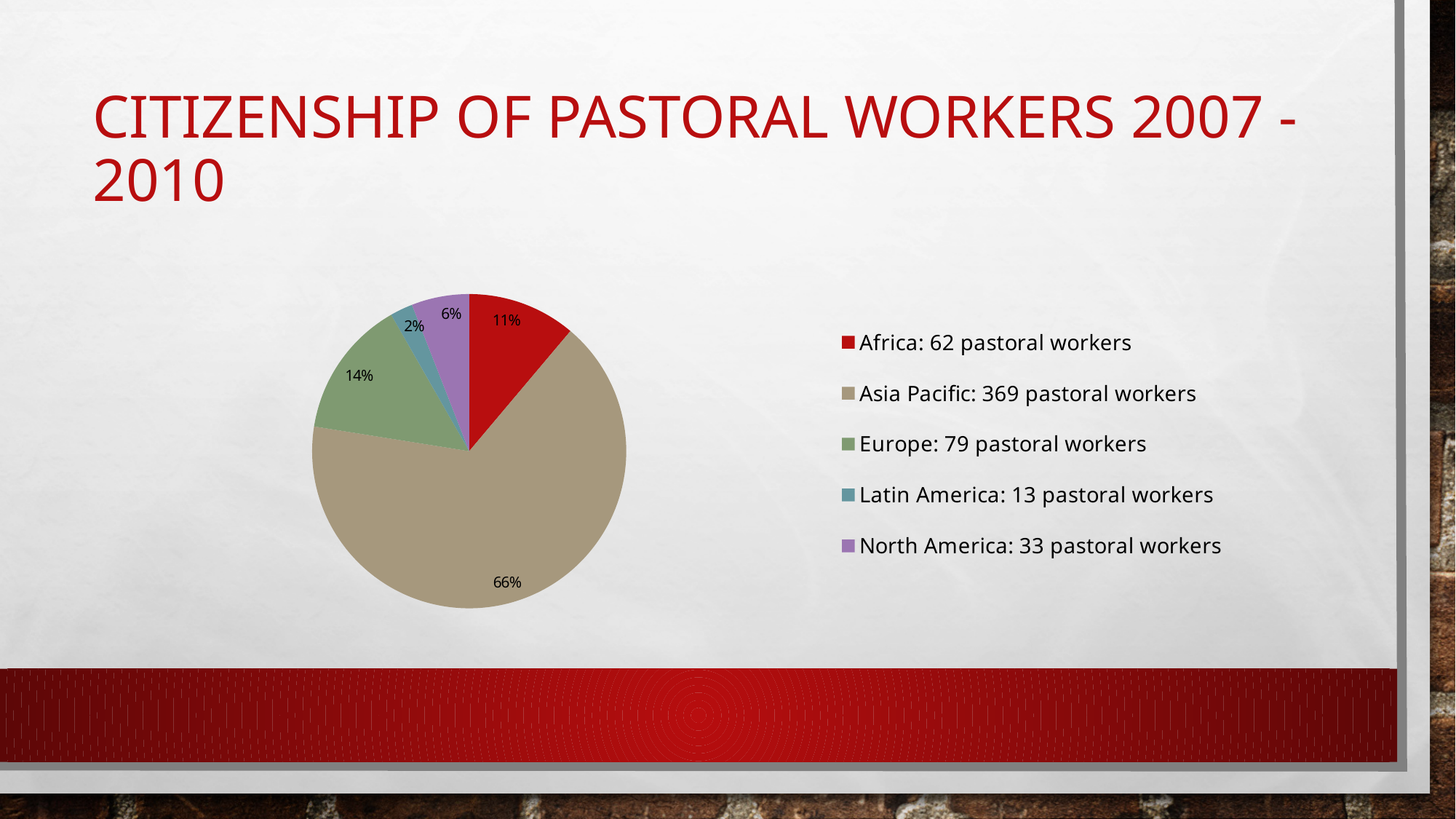
What percentage share of the pie does Latin America have? 2% How many pastoral workers does the legend list for North America? 33 pastoral workers What type of chart is shown on the slide? pie chart What percentage share of the pie does Asia Pacific have? 66% How many regions (slices) are shown in the pie chart? 5 How many pastoral workers does the legend list for Africa? 62 pastoral workers Which region has the smallest slice of the pie? Latin America What is the difference in pastoral workers between Asia Pacific and Europe? 290 What percentage share of the pie does Europe have? 14% Which region has the largest slice of the pie? Asia Pacific Which has more pastoral workers, Europe or Africa? Europe What colour is the Asia Pacific slice in the pie chart? tan (beige)